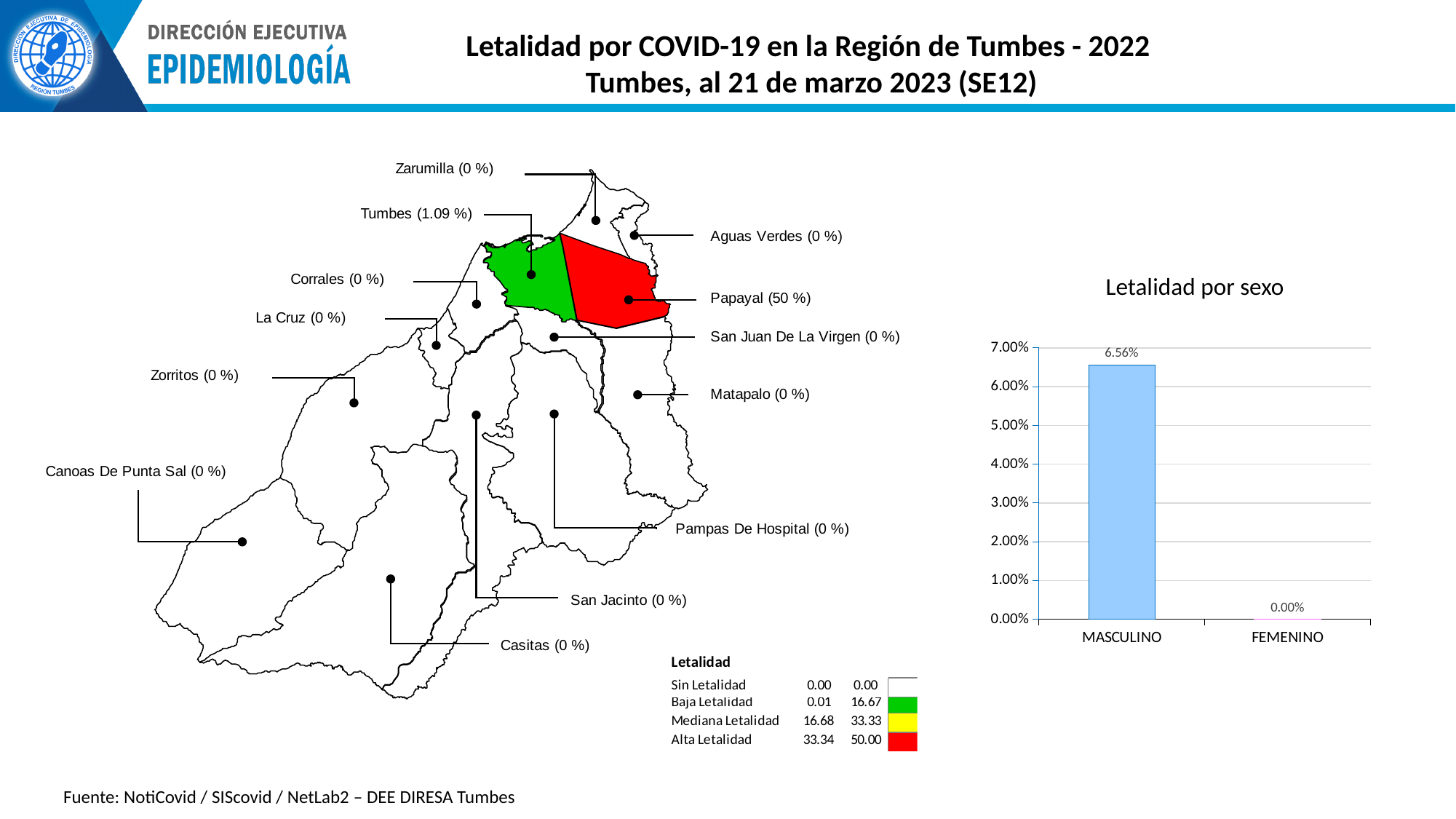
In the 'Letalidad por sexo' chart, what is the difference between the MASCULINO and FEMENINO values? 6.56% In the 'Letalidad por sexo' chart, what is the highest value shown on the y axis? 7.00% What is the title of the bar chart on the right side of the slide? Letalidad por sexo How many categories are shown on the x axis of the 'Letalidad por sexo' chart? 2 On the map of the Tumbes region, what lethality percentage is shown for Papayal? 50 % In the 'Letalidad por sexo' chart, which category has the lowest value? FEMENINO In the 'Letalidad por sexo' chart, what is the value for MASCULINO? 6.56% In the 'Letalidad por sexo' chart, which category has the highest value? MASCULINO In the 'Letalidad por sexo' chart, is the value for MASCULINO greater or less than 6.00%? greater In the 'Letalidad por sexo' chart, which is larger, the value for MASCULINO or for FEMENINO? MASCULINO What kind of chart is 'Letalidad por sexo'? bar chart In the 'Letalidad por sexo' chart, what is the value for FEMENINO? 0.00%